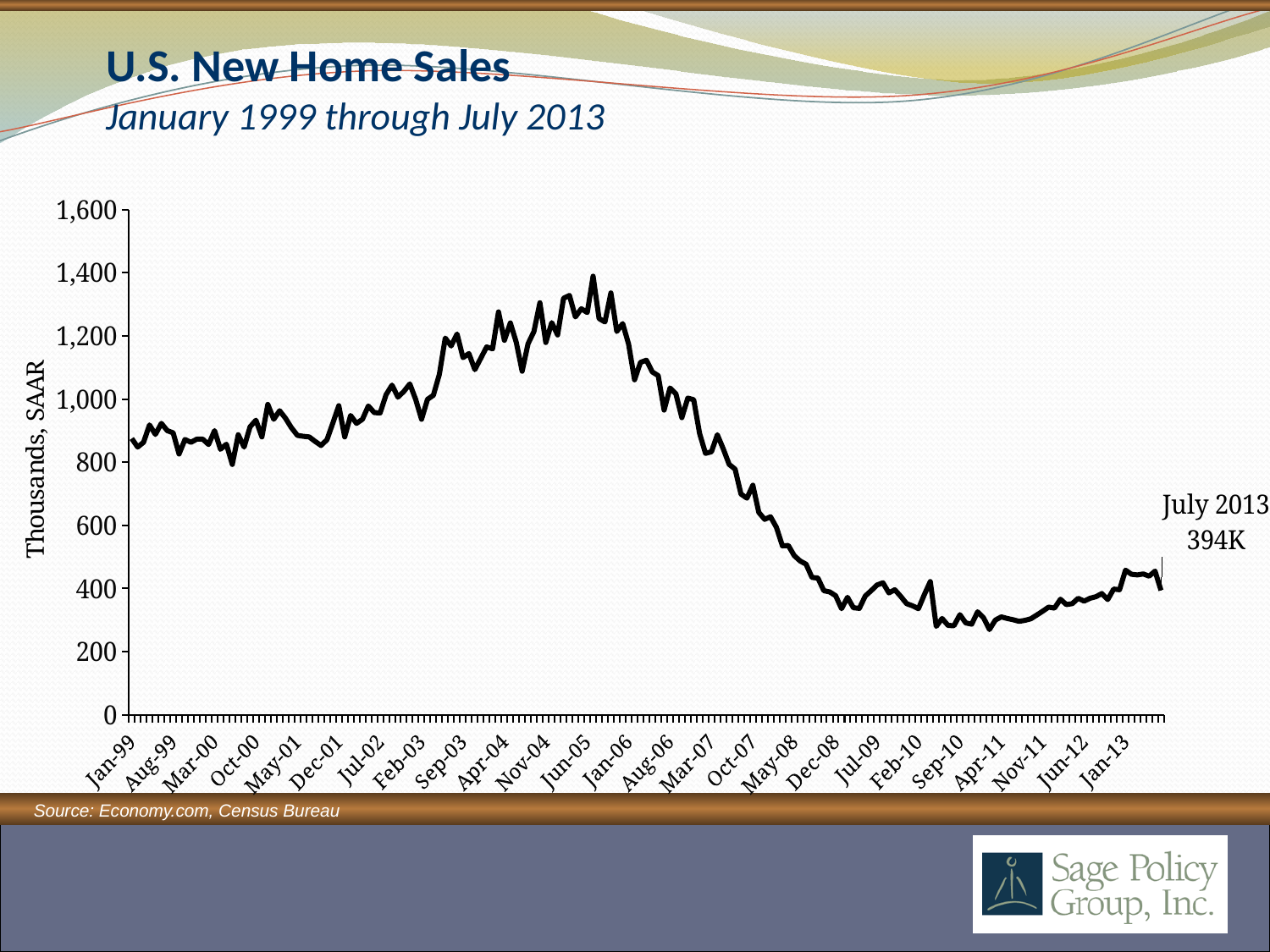
Is the value at Sep-10 greater or less than 400? less Which is larger, the value at Jun-05 or the value at Sep-10? Jun-05 What is the label on the vertical axis of the chart? Thousands, SAAR What kind of chart is shown on the slide? line chart What is the title of the chart on the slide? U.S. New Home Sales Near which x-axis label does the line reach its highest point? Jun-05 Is the value at Jan-06 greater or less than 1,000? greater What value is labeled for July 2013 on the chart? 394K Is the value at Jun-05 greater or less than 1,200? greater Does the line rise or fall between Jun-05 and Dec-08? fall